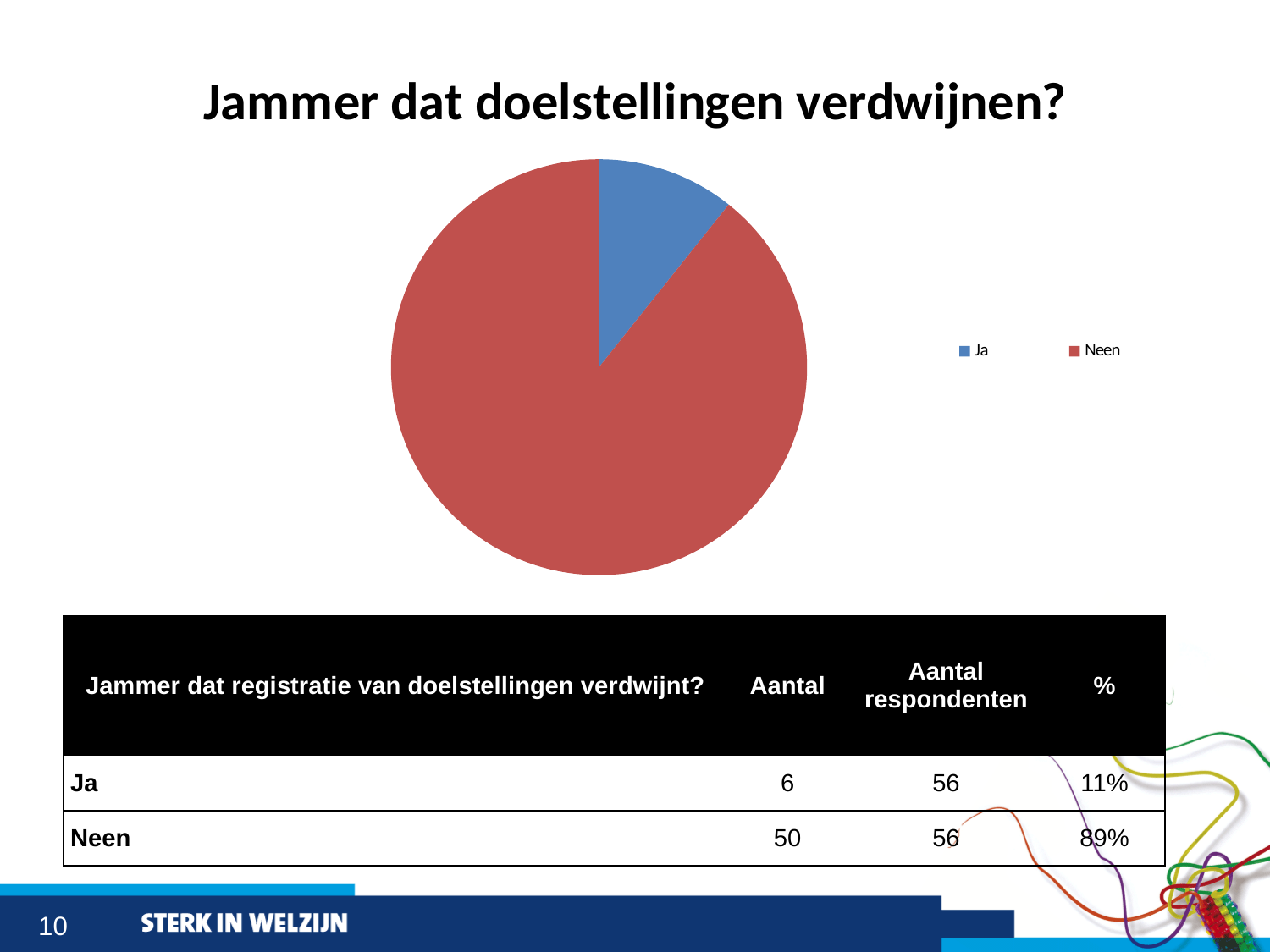
How many entries does the legend of the pie chart list? 2 According to the table below the pie chart, what share of respondents answered Ja? 11% What is the difference between the number of Neen answers and the number of Ja answers shown in the table? 44 Which slice of the pie chart is the smallest? Ja What kind of chart is shown on the slide? pie chart Which slice of the pie chart is the largest? Neen According to the table below the pie chart, what share of respondents answered Neen? 89% According to the table below the pie chart, how many respondents answered Ja (Aantal)? 6 Which is larger in the pie chart, the Ja slice or the Neen slice? Neen What colour is the Ja slice in the pie chart? blue How many slices does the pie chart have? 2 According to the table below the pie chart, how many respondents answered Neen (Aantal)? 50